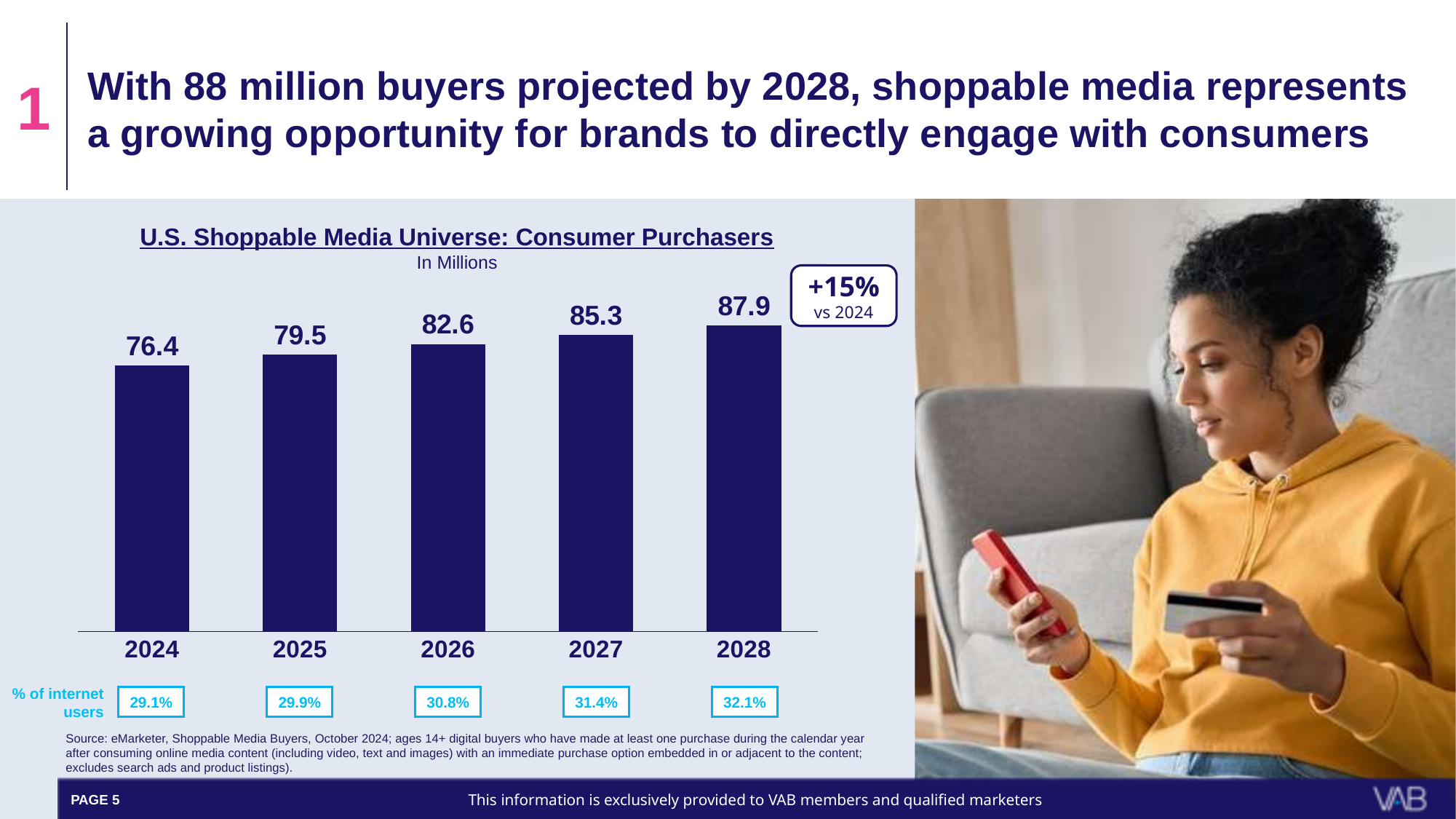
Which year has the highest value in the chart? 2028 Which year has the lowest value in the chart? 2024 Do the values rise or fall from 2024 to 2028? Rise What is the value for 2028 in the U.S. Shoppable Media Universe: Consumer Purchasers chart? 87.9 What is the difference between the 2027 value and the 2025 value? 5.8 What kind of chart is shown on the slide? Bar chart What is the value for 2026 in the chart? 82.6 Which is larger, the value for 2025 or the value for 2027? 2027 What is the difference between the 2028 value and the 2024 value? 11.5 How many years are shown in the chart? 5 What percentage of internet users is shown for 2028 below the chart? 32.1% What is the value for 2024 in the U.S. Shoppable Media Universe: Consumer Purchasers chart? 76.4